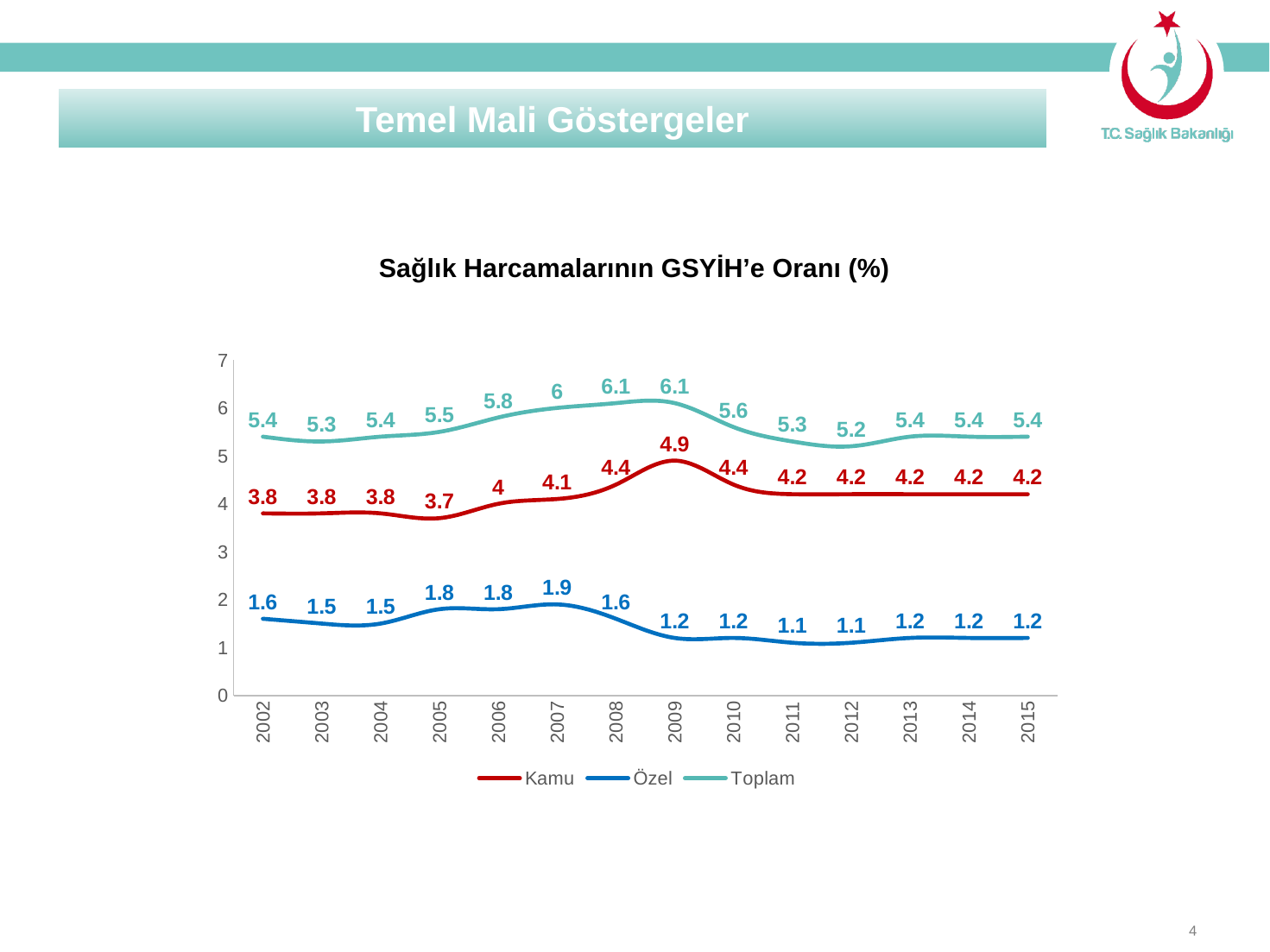
What is the value for Özel in 2007? 1.9 Does the Özel series rise or fall from 2007 to 2011? fall What kind of chart is shown on the slide? line chart How many series does the legend list? 3 How many years are shown on the x axis? 14 What is the difference between the Toplam value in 2008 and the Toplam value in 2012? 0.9 What is the value for Kamu in 2009? 4.9 Which is larger: the Özel value in 2002 or the Özel value in 2015? 2002 What is the title of the chart? Sağlık Harcamalarının GSYİH'e Oranı (%) What is the lowest value shown for the Özel series? 1.1 What is the value for Toplam in 2012? 5.2 In which year is the Kamu series highest? 2009